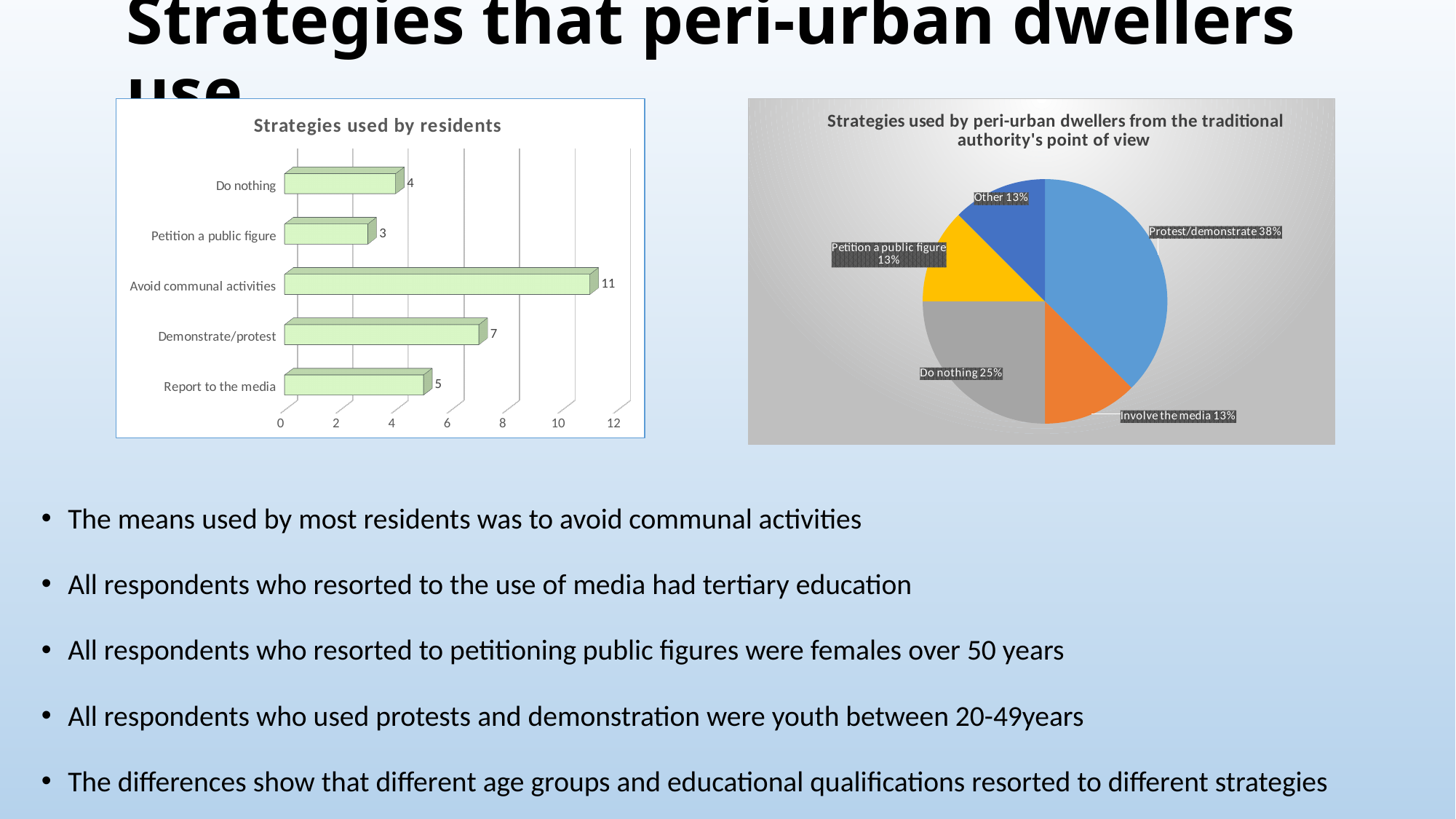
In the 'Strategies used by residents' chart, what is the value for Avoid communal activities? 11 In the 'Strategies used by residents' chart, which is larger: Report to the media or Do nothing? Report to the media In the pie chart on the right, what share does Protest/demonstrate have? 38% In the 'Strategies used by residents' chart, which category has the highest value? Avoid communal activities How many categories are shown in the 'Strategies used by residents' chart? 5 In the pie chart on the right, which slice is the largest? Protest/demonstrate What kind of chart is 'Strategies used by residents'? Bar chart In the 'Strategies used by residents' chart, which category has the lowest value? Petition a public figure In the 'Strategies used by residents' chart, what is the difference between Avoid communal activities and Demonstrate/protest? 4 How many slices does the pie chart on the right have? 5 In the pie chart on the right, what share does Do nothing have? 25% In the 'Strategies used by residents' chart, what is the value for Petition a public figure? 3